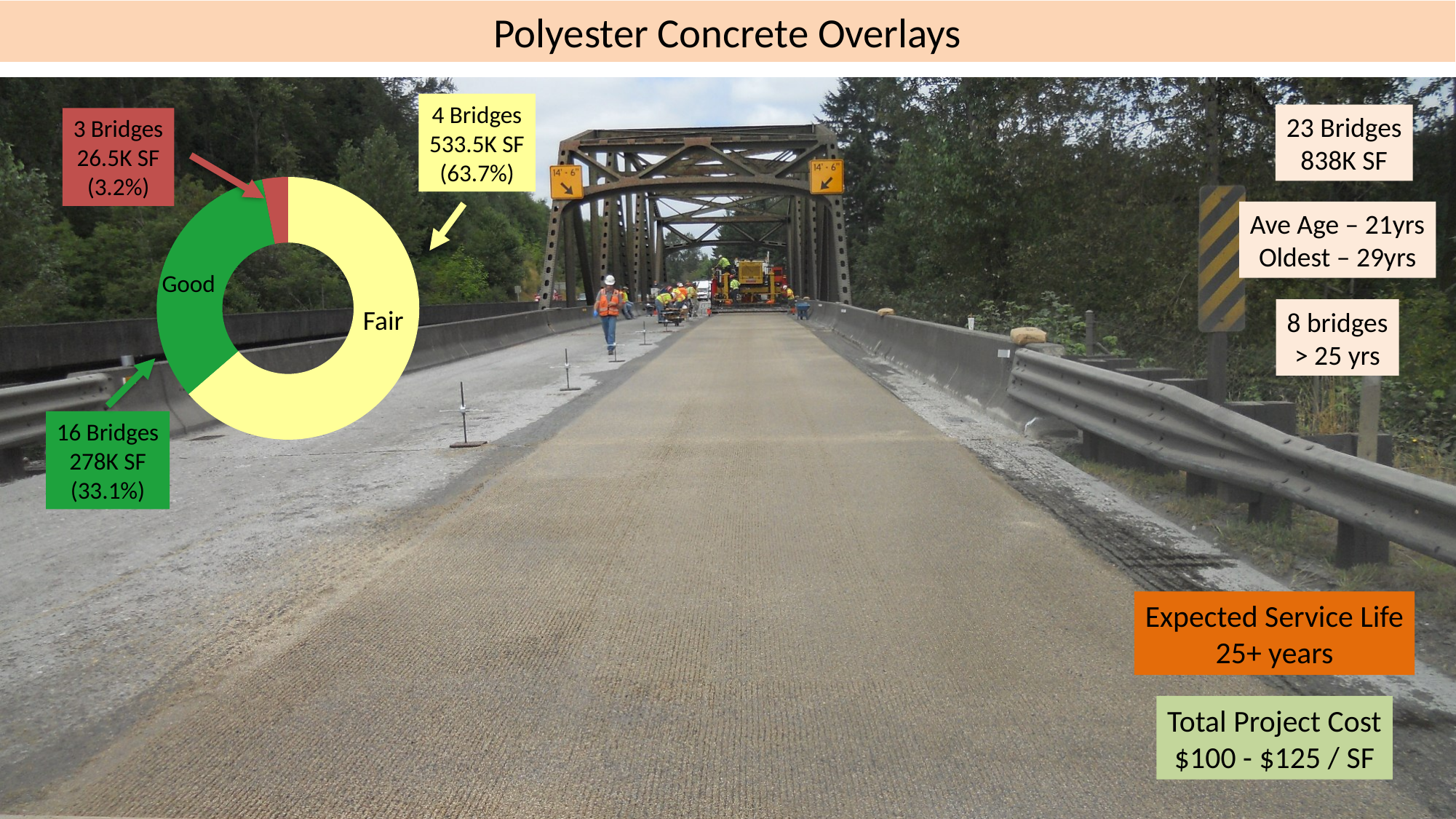
What colour is the Fair slice of the donut chart? Yellow What share of the donut chart does the red slice represent? 3.2% How many bridges are in the Fair category? 4 Bridges What is the square footage for the Fair slice? 533.5K SF What share of the donut chart does the Fair slice represent? 63.7% What kind of chart is shown on the slide? Pie (donut) chart How many slices does the donut chart have? 3 Which has more bridges, the Good slice or the Fair slice? Good What share of the donut chart does the Good slice represent? 33.1% Which slice of the donut chart is the smallest by area? The red slice (3 Bridges, 26.5K SF) How many bridges are in the Good category? 16 Bridges Which slice of the donut chart is the largest by area? Fair